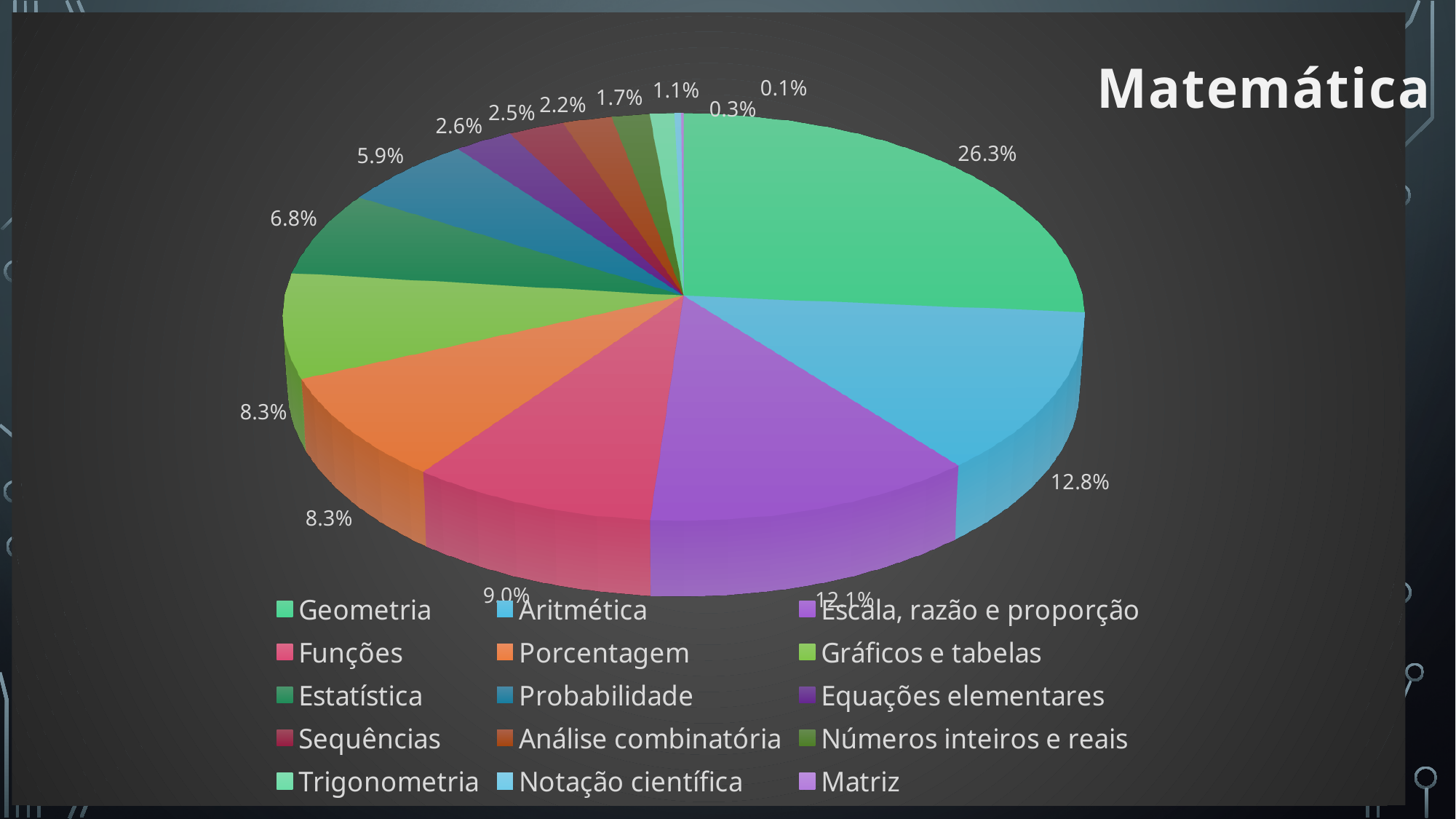
How many categories does the legend list? 15 What percentage does the Geometria slice represent? 26.3% What percentage does the Estatística slice represent? 6.8% What type of chart is shown on the slide? pie chart Which is larger, the share for Funções or the share for Porcentagem? Funções Which category has the largest share of the pie? Geometria What percentage does the Aritmética slice represent? 12.8% Which category has the smallest share of the pie? Matriz What is the combined share of Porcentagem and Gráficos e tabelas? 16.6% What percentage does the Probabilidade slice represent? 5.9% What is the difference in percentage points between Geometria and Aritmética? 13.5 What is the title of the chart? Matemática